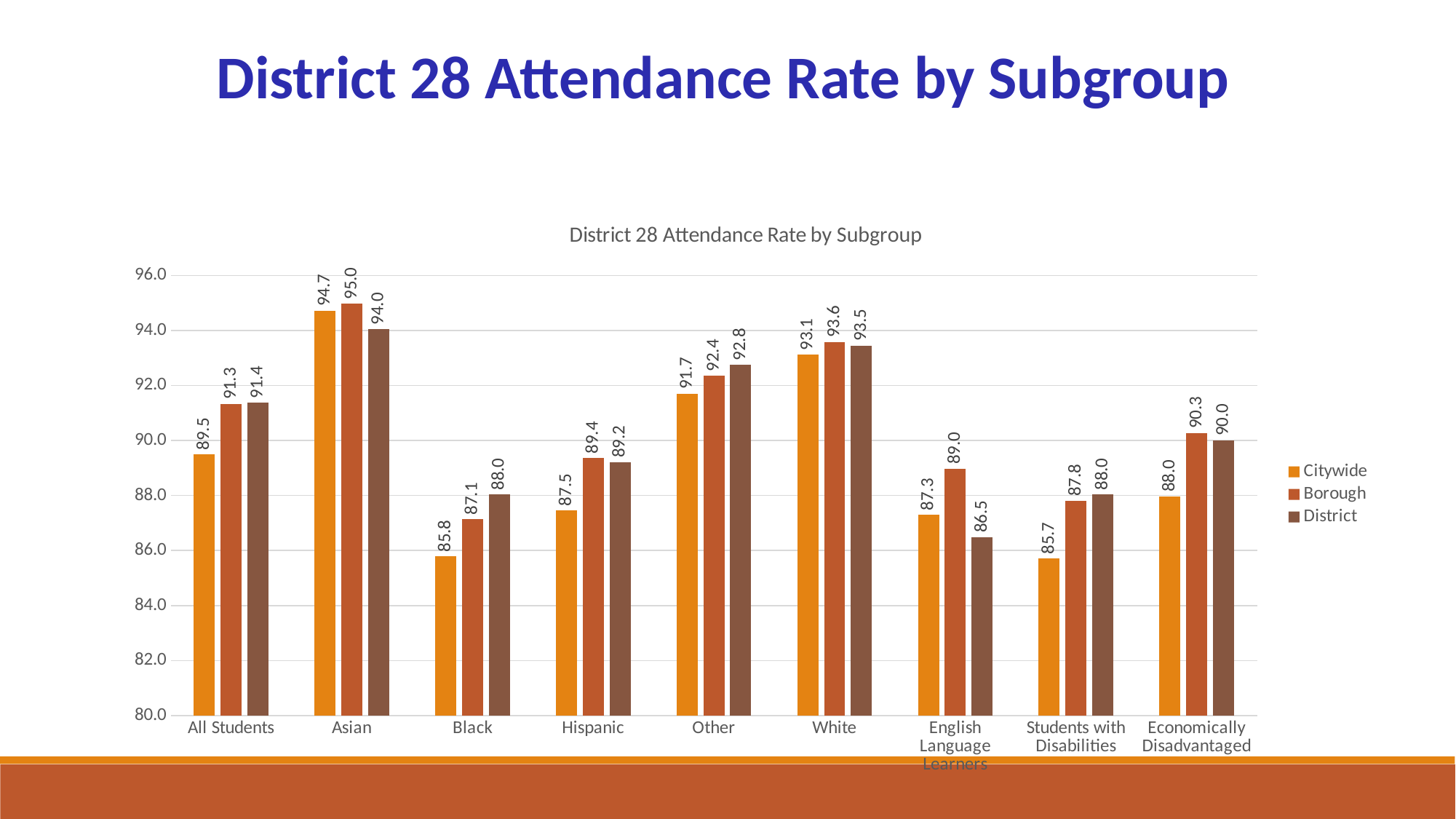
Which subgroup has the lowest Citywide attendance rate? Students with Disabilities What is the Citywide attendance rate for Students with Disabilities? 85.7 What is the District attendance rate for Asian students? 94.0 How many series does the legend list? 3 For English Language Learners, is the Borough or the District attendance rate higher? Borough Which series is shown in the darkest brown colour? District Is the Citywide attendance rate for Hispanic students greater or less than 88.0? less What kind of chart is shown on the slide? bar chart What is the Borough attendance rate for English Language Learners? 89.0 How many subgroups are shown on the x axis? 9 What is the difference between the District and Citywide attendance rates for Black students? 2.2 Which subgroup has the highest District attendance rate? Asian